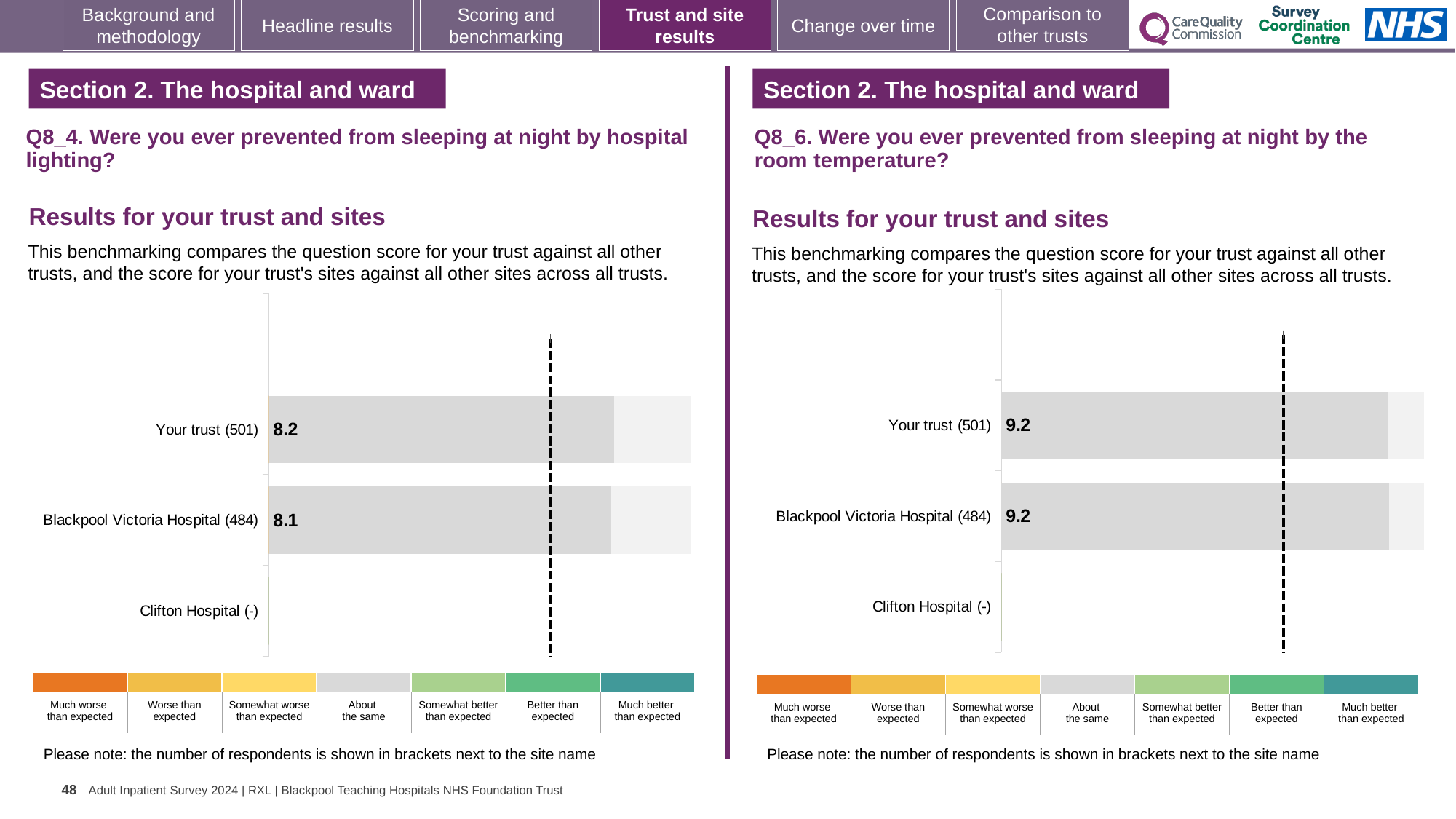
In the Q8_4 hospital lighting chart on the left, what is the difference between the score for Your trust and the score for Blackpool Victoria Hospital? 0.1 What kind of chart is used for the Q8_6 room temperature results on the right? Bar chart In the Q8_4 hospital lighting chart on the left, which has the higher score: Your trust or Blackpool Victoria Hospital? Your trust In the Q8_6 room temperature chart on the right, what is the score for Blackpool Victoria Hospital (484)? 9.2 In the Q8_4 hospital lighting chart on the left, what is the score for Your trust (501)? 8.2 In the Q8_4 hospital lighting chart on the left, which category has no score shown? Clifton Hospital (-) In the Q8_4 hospital lighting chart on the left, what is the score for Blackpool Victoria Hospital (484)? 8.1 In the Q8_6 room temperature chart on the right, what is the score for Your trust (501)? 9.2 In the Q8_6 room temperature chart on the right, what is the difference between the score for Your trust and the score for Blackpool Victoria Hospital? 0 In the Q8_6 room temperature chart on the right, how many respondents are shown in brackets for Blackpool Victoria Hospital? 484 How many sites or categories are listed on the y axis of the Q8_4 hospital lighting chart on the left? 3